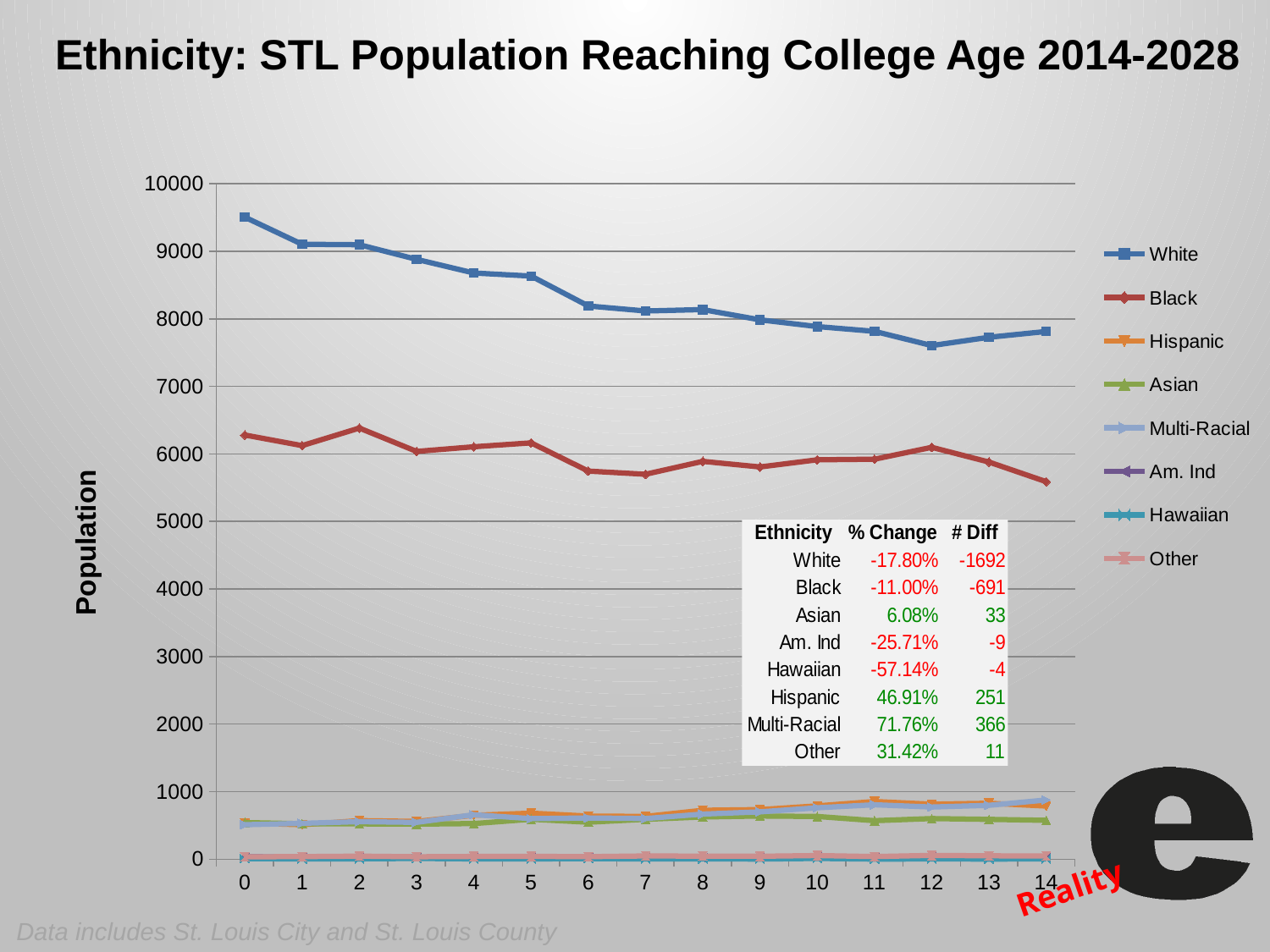
Which series has the highest value at x = 0? White Is the value for Black at x = 14 greater or less than 6000? less According to the table on the chart, what is the % Change for White? -17.80% Is the value for White at x = 0 greater or less than 9000? greater At x = 0, which is larger, the value for White or the value for Black? White How many points are plotted along the x axis for each series? 15 Does the White series rise or fall overall from x = 0 to x = 14? fall According to the table on the chart, what is the # Diff for Multi-Racial? 366 What kind of chart is shown on the slide? line chart What is the title of the y axis? Population Is the value for White at x = 12 greater or less than 8000? less How many series does the legend list? 8